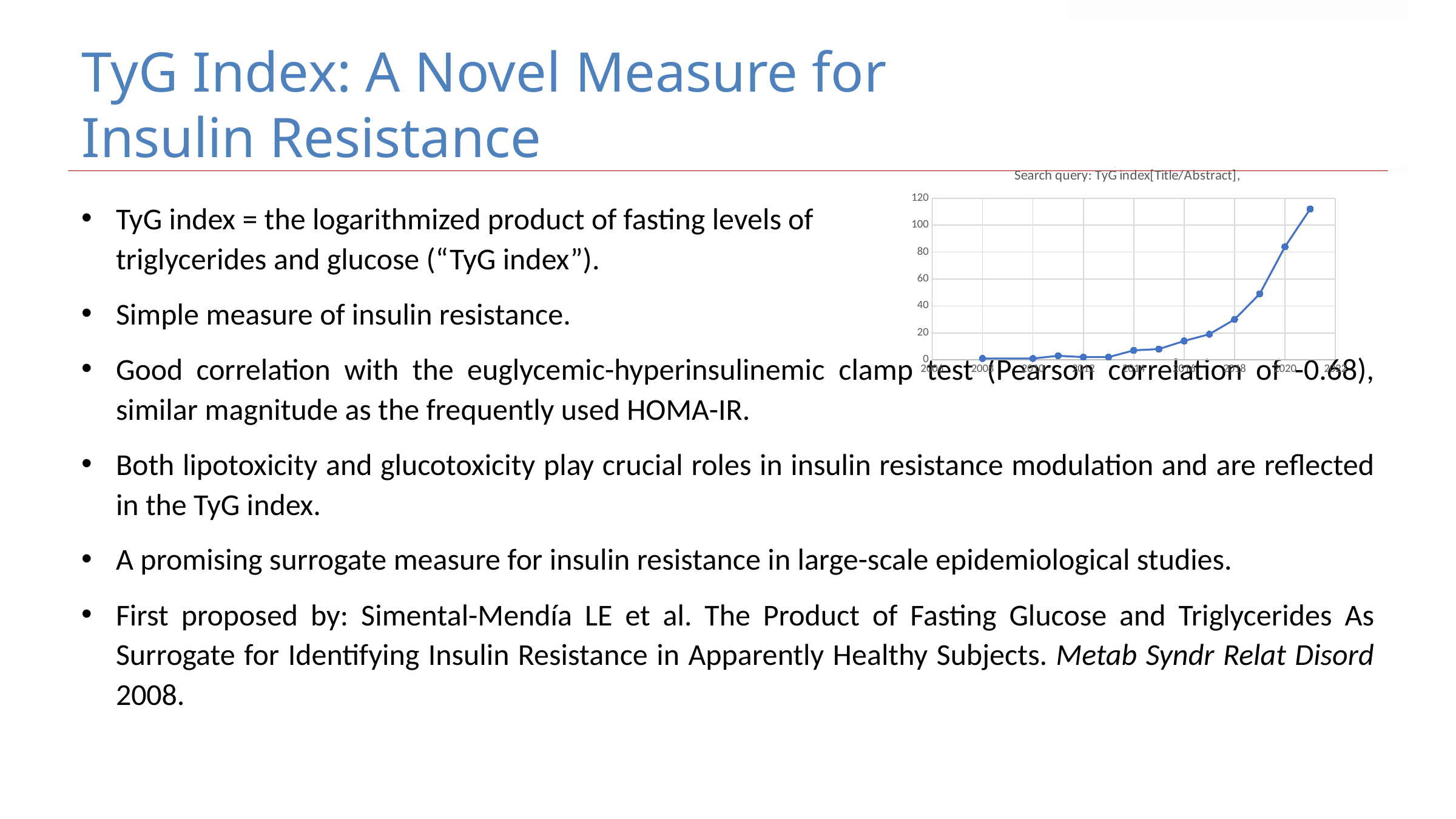
Is the value for 2020 greater or less than 60? greater What is the highest tick value shown on the chart's vertical axis? 120 What search query is named in the chart's title? TyG index[Title/Abstract] Which year has the larger value, 2014 or 2018? 2018 Is the value for 2016 greater or less than 20? less Is the value for 2014 greater or less than 20? less What kind of chart is shown on the slide? line chart Do the values in the chart generally rise or fall from left to right along the x axis? rise Which year has the larger value, 2016 or 2020? 2020